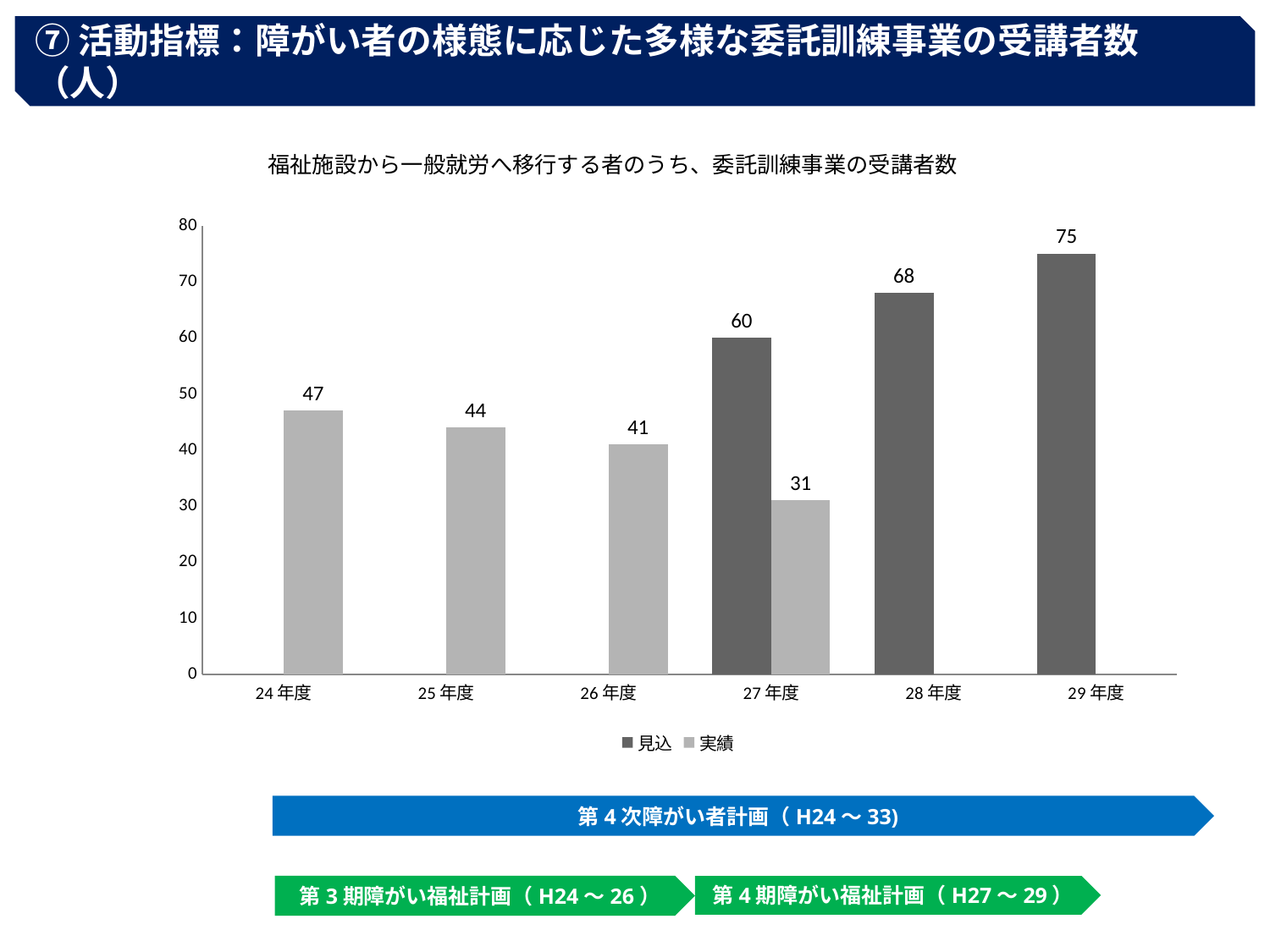
How many years are shown on the x axis? 6 What is the 実績 value for 27年度? 31 What is the 見込 value for 29年度? 75 What is the 実績 value for 24年度? 47 How many series does the legend list? 2 What is the 見込 value for 27年度? 60 What kind of chart is shown on the slide? Bar chart Which is larger, the 実績 value for 25年度 or the 実績 value for 26年度? 25年度 Do the 実績 values rise or fall from 24年度 to 27年度? Fall What is the difference between the 見込 and 実績 values for 27年度? 29 Which year has the lowest 実績 value? 27年度 Which year has the highest 見込 value? 29年度